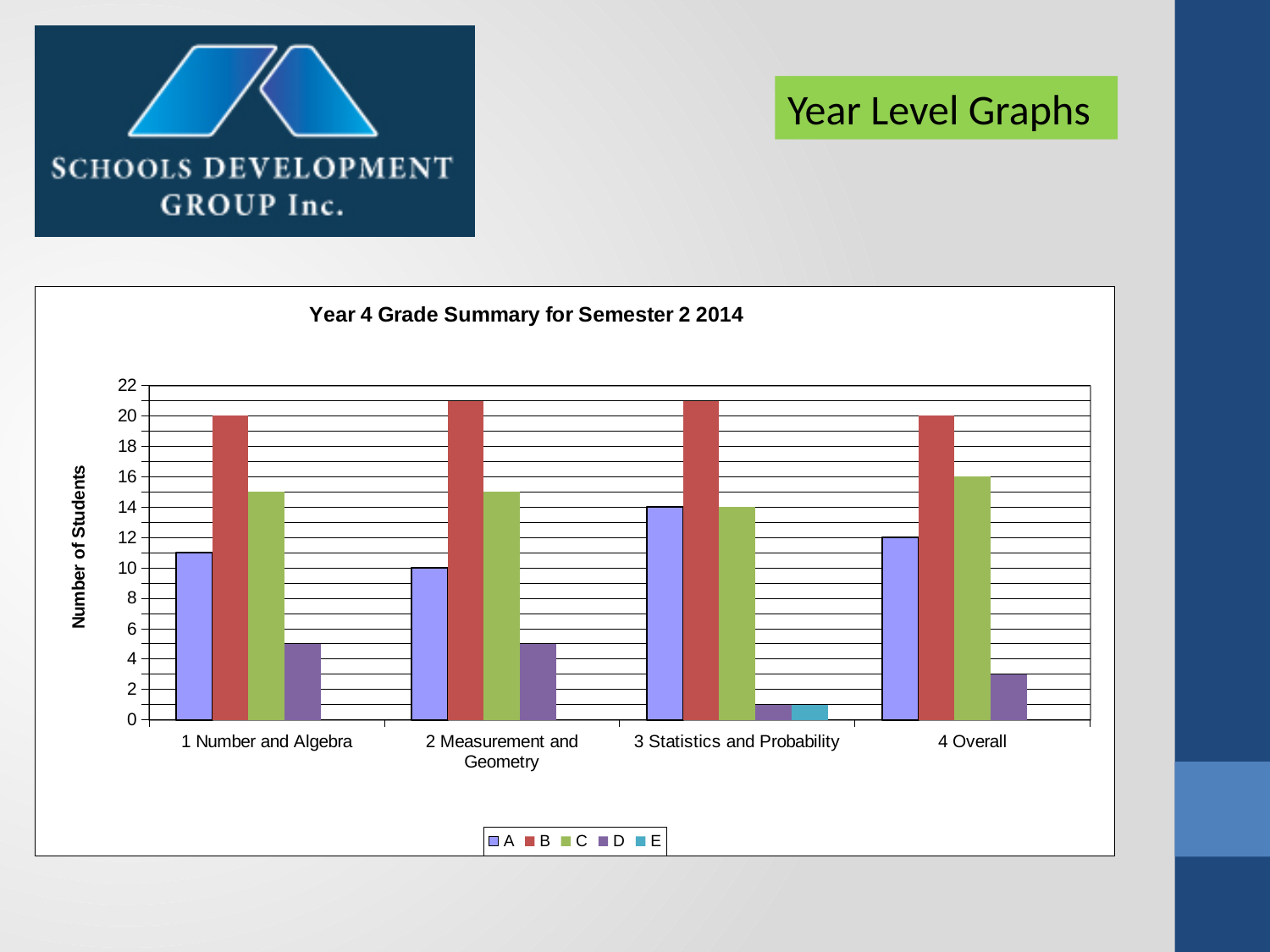
Is the value for grade D in 1 Number and Algebra greater or less than 10? less Which is larger: grade A in 3 Statistics and Probability or grade A in 2 Measurement and Geometry? 3 Statistics and Probability What is the difference between grade C and grade A in 4 Overall? 4 How many categories are shown on the x axis? 4 What is the title of the chart? Year 4 Grade Summary for Semester 2 2014 What type of chart is shown on the slide? bar chart Which grade has the highest number of students in 3 Statistics and Probability? B What is the number of students with grade A in 2 Measurement and Geometry? 10 What is the number of students with grade B in 1 Number and Algebra? 20 How many series does the legend list? 5 What is the number of students with grade C in 4 Overall? 16 What is the number of students with grade A in 4 Overall? 12